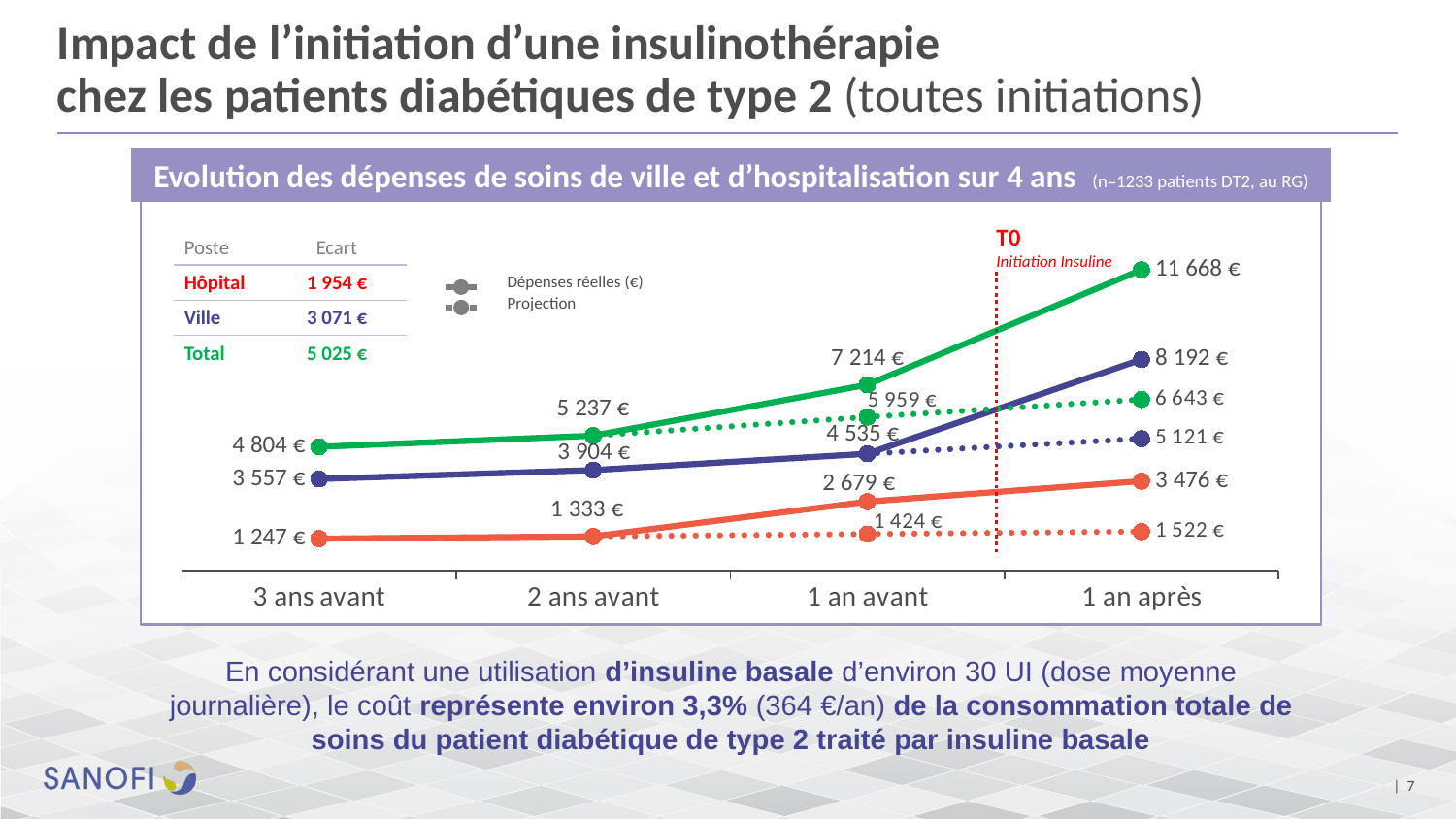
At which time point is the real total expenditure (green line) highest? 1 an après What kind of chart is shown on the slide? line chart What is the real hospital expenditure (red line) at '3 ans avant'? 1 247 € Does the real 'Ville' expenditure (blue line) rise or fall from '3 ans avant' to '1 an après'? rise According to the table on the slide, what is the 'Ecart' for 'Total'? 5 025 € What is the difference between the real total expenditure at '1 an après' and at '3 ans avant'? 6 864 € How many time points are shown on the x axis of the chart? 4 At which time point is the real hospital expenditure (red line) lowest? 3 ans avant What is the real 'Ville' expenditure (blue line) at '1 an avant'? 4 535 € What is the real total expenditure (green line) at '1 an après'? 11 668 € What is the projected hospital expenditure (red dotted line) at '1 an avant'? 1 424 € What is the projected total expenditure (green dotted line) at '1 an après'? 6 643 €